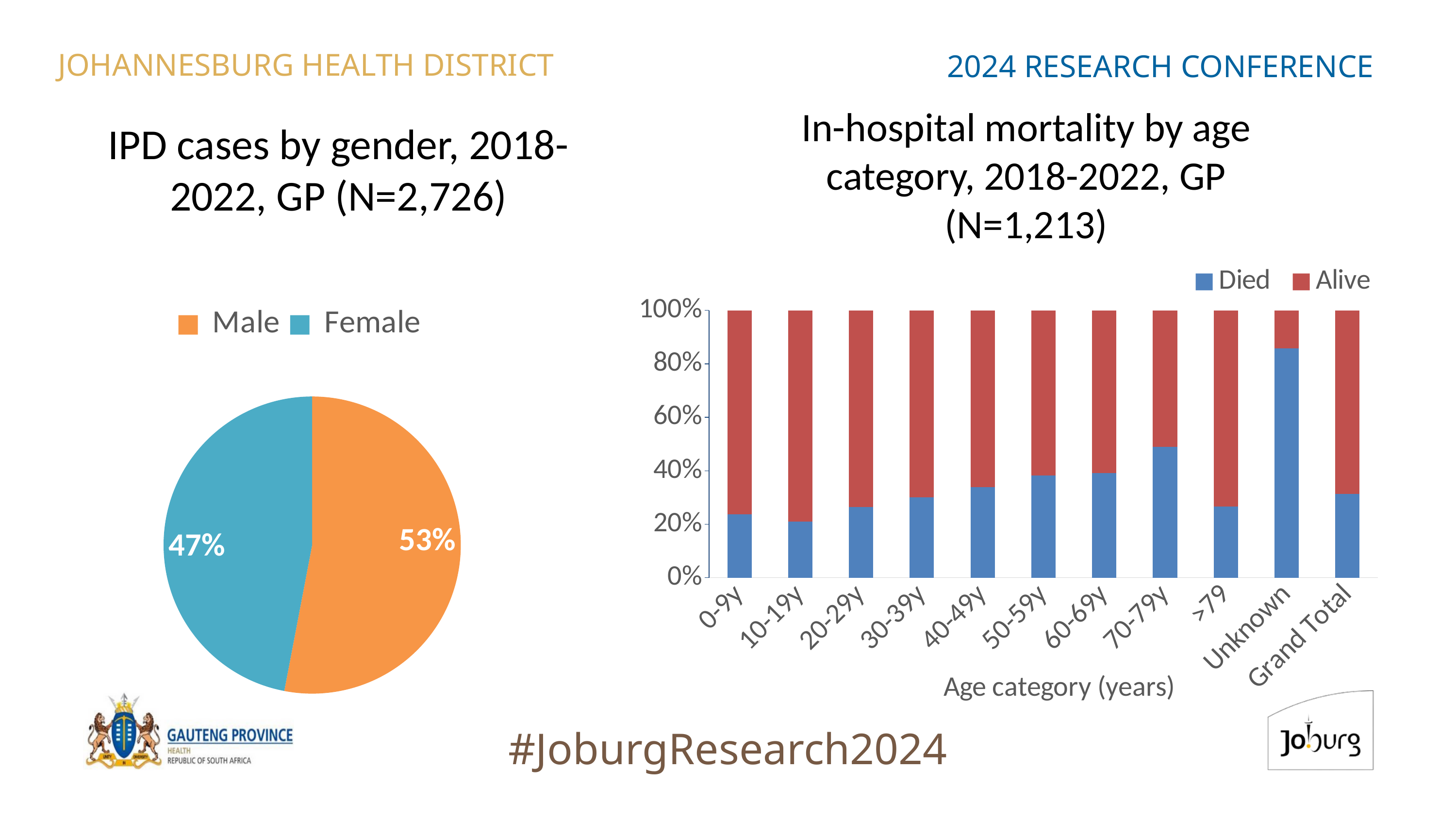
In the 'In-hospital mortality by age category' chart, how many series does the legend list? 2 In the 'In-hospital mortality by age category' chart, which age category has the highest proportion of patients who died? Unknown In the 'In-hospital mortality by age category' chart, is the 'Died' proportion for the Unknown category greater or less than 80%? greater In the 'In-hospital mortality by age category' chart, is the 'Died' proportion for the 70-79Y category greater or less than 60%? less In the pie chart 'IPD cases by gender', what is the difference in percentage points between the male and female shares? 6 What type of chart is the 'IPD cases by gender' chart on the left? Pie chart In the pie chart 'IPD cases by gender', what percentage of IPD cases were male? 53% In the 'In-hospital mortality by age category' chart, how many age categories (bars) are shown on the x axis? 11 In the 'In-hospital mortality by age category' chart, which has the larger 'Died' proportion: 70-79Y or 0-9Y? 70-79Y In the pie chart 'IPD cases by gender', which gender has the larger share of cases? Male In the pie chart 'IPD cases by gender', what percentage of IPD cases were female? 47% What type of chart is the 'In-hospital mortality by age category' chart on the right? Stacked bar chart